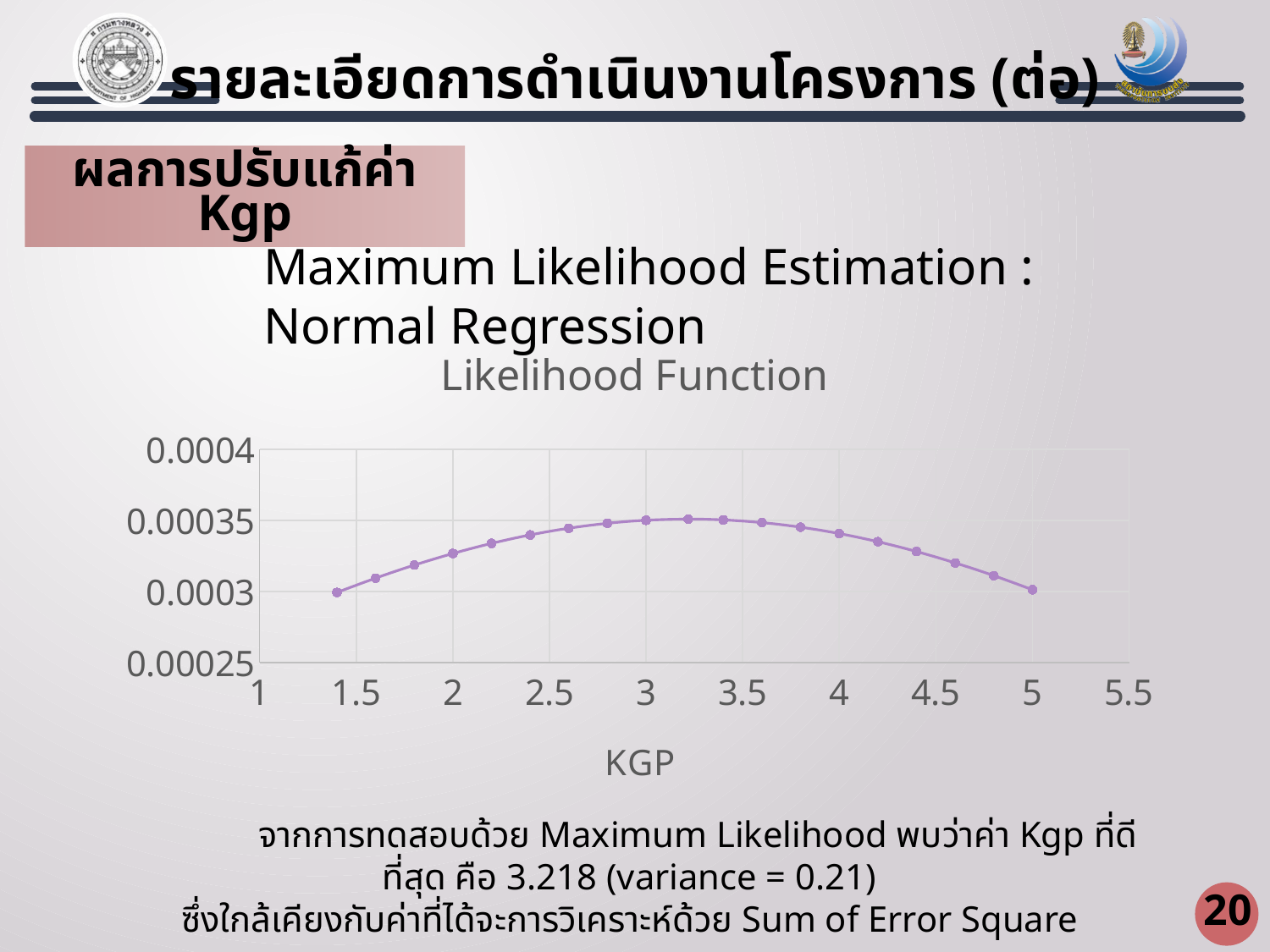
How many series are plotted on the chart? 1 How many data points are plotted on the line? 19 Between which two x-axis ticks does the line reach its highest point? Between 3 and 3.5 What kind of chart is shown on the slide? Line chart Which is larger, the value at KGP = 3 or the value at KGP = 5? KGP = 3 How does the likelihood value change as KGP increases from left to right? It rises to a peak and then falls Is the value at KGP = 2 greater or less than 0.00035? less Which is larger, the value at KGP = 2 or the value at KGP = 4? KGP = 4 Is the value at KGP = 5 greater or less than 0.00035? less What is the title of the chart? Likelihood Function Is the value at KGP = 3 greater or less than 0.0003? greater What is the label of the x axis of the chart? KGP